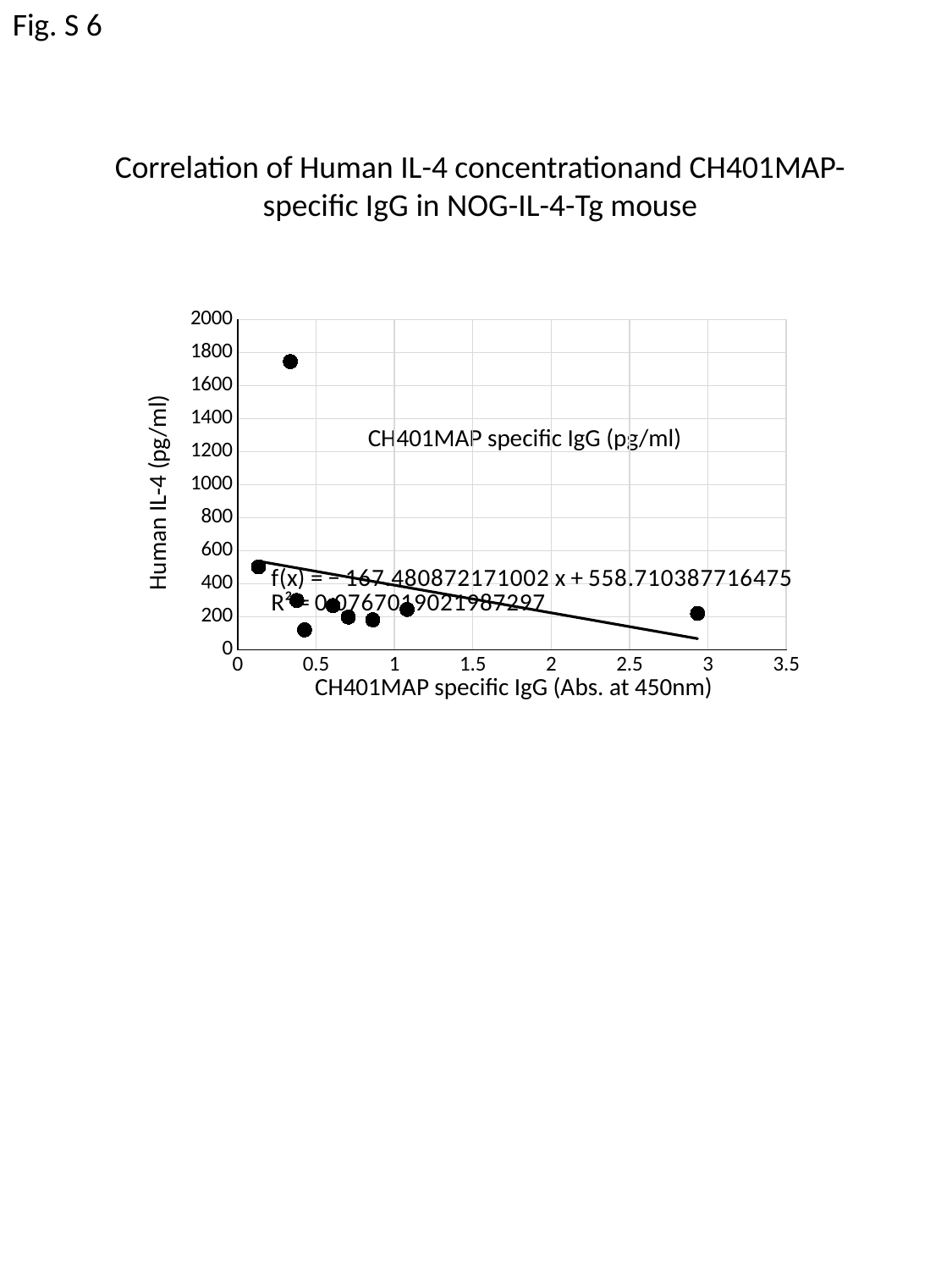
What kind of chart is shown on the slide? scatter chart How many plotted points have a Human IL-4 value above 1000 pg/ml? 1 Is the Human IL-4 value of the point with the highest absorbance (near 3) greater or less than 400? less Is the Human IL-4 value of the lowest plotted point greater or less than 200? less What is the label of the x axis? CH401MAP specific IgG (Abs. at 450nm) How many plotted points have an absorbance greater than 2? 1 What is the label of the y axis? Human IL-4 (pg/ml) Is the Human IL-4 value of the highest plotted point greater or less than 1600? greater Which is larger: the Human IL-4 value of the point near absorbance 0.33 or the point near absorbance 2.9? the point near absorbance 0.33 How many data points are plotted in the chart? 9 Does the fitted trend line rise or fall as CH401MAP specific IgG absorbance increases? fall